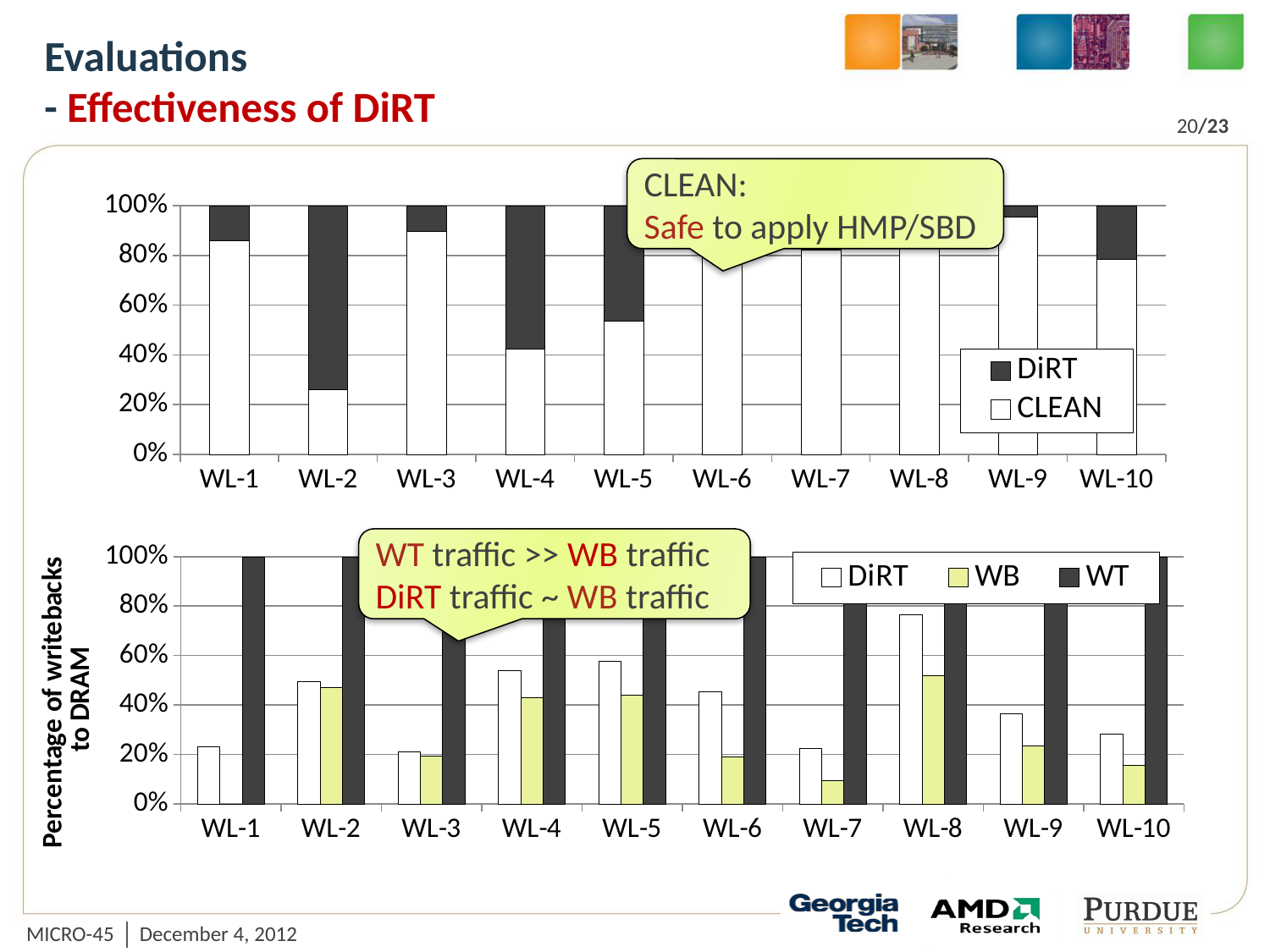
What is the y-axis title of the bottom chart? Percentage of writebacks to DRAM In the top chart, which workload has the lowest CLEAN share? WL-2 What kind of chart is the bottom chart? bar chart In the bottom chart, which workload has the highest DiRT value? WL-8 In the bottom chart, which is larger for WL-6: the DiRT value or the WB value? DiRT In the top chart, which workload has the largest DiRT share? WL-2 In the top chart, how many series does the legend list? 2 In the top chart, how many workloads (categories) are shown on the x axis? 10 In the bottom chart, is the DiRT value for WL-8 greater or less than 60%? greater In the top chart, is the CLEAN value for WL-4 greater or less than 60%? less In the top chart, what is the total of the stacked bar for WL-1? 100% In the bottom chart, how many series does the legend list? 3